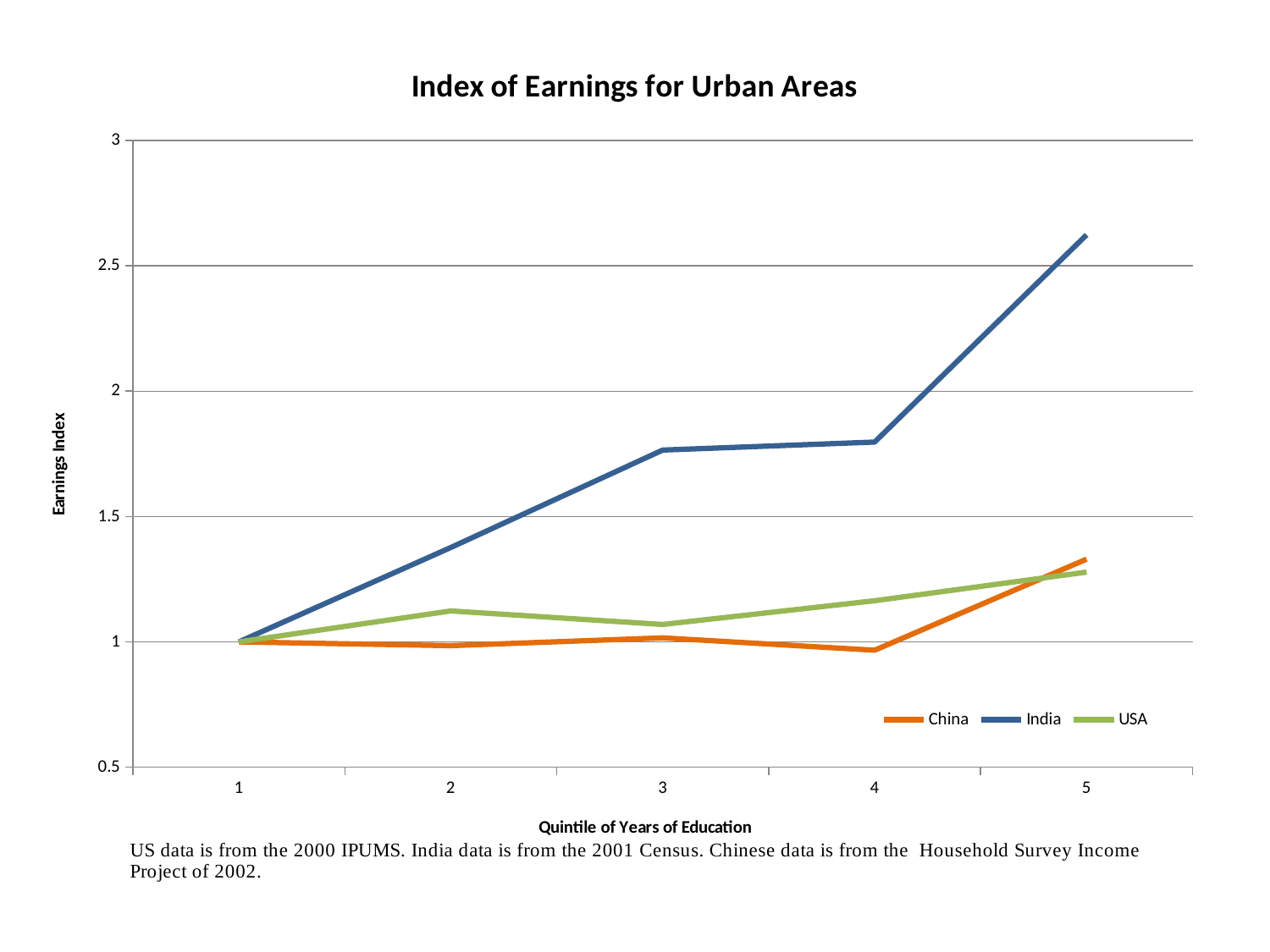
At quintile 3, which is larger, the earnings index for India or for USA? India How many series does the legend list? 3 What is the title of the chart? Index of Earnings for Urban Areas How many quintiles are plotted along the x axis? 5 Is the earnings index for USA at quintile 5 greater or less than 1.5? less What kind of chart is shown on the slide? line chart What is the earnings index for India at quintile 1? 1 Does the earnings index for India rise or fall from quintile 1 to quintile 5? rise Is the earnings index for India at quintile 4 greater or less than 2? less Which country has the highest earnings index at quintile 5? India Is the earnings index for India at quintile 5 greater or less than 2.5? greater Which country has the lowest earnings index at quintile 4? China